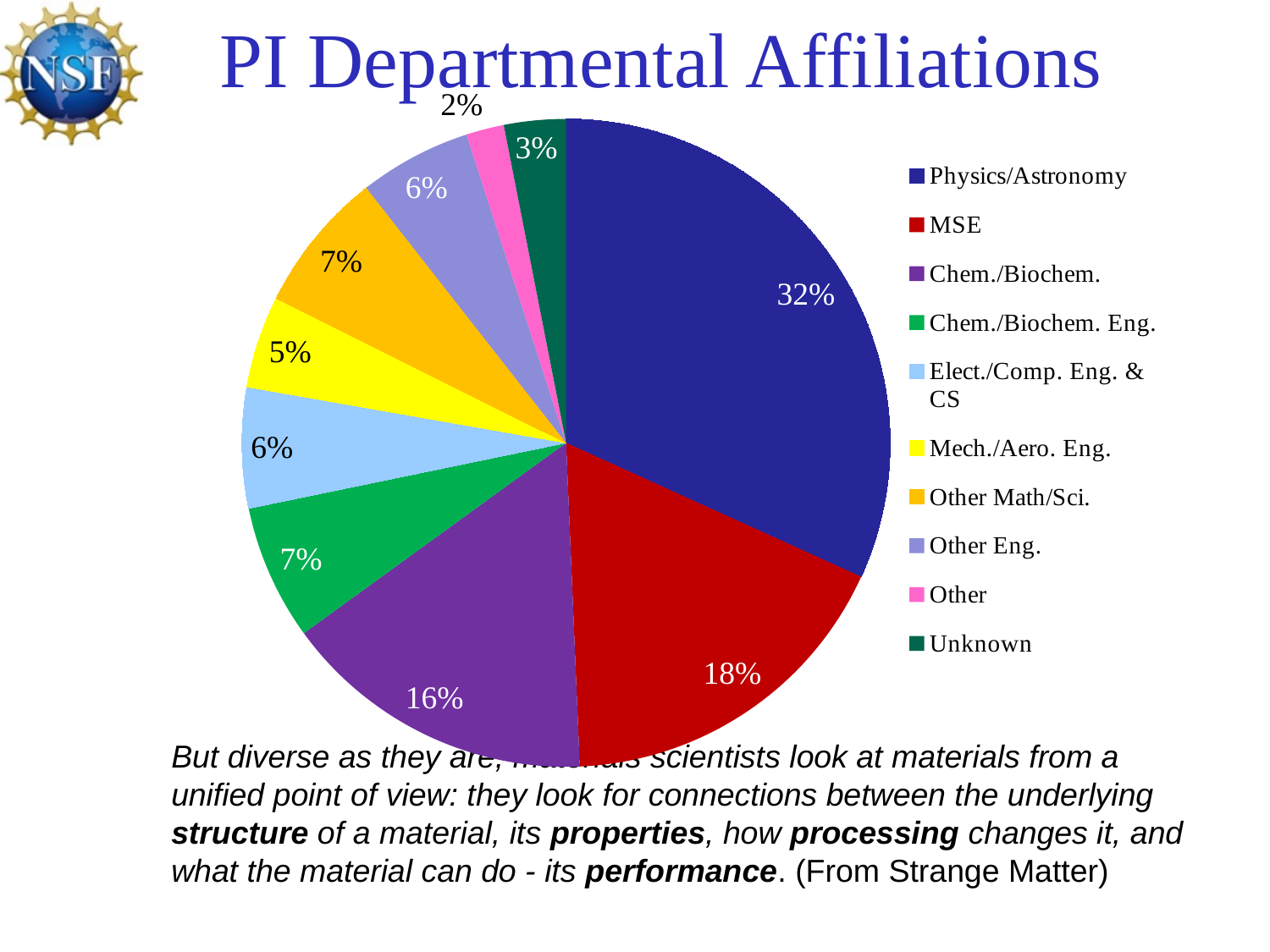
What share of the pie is MSE? 18% What share of the pie is Chem./Biochem.? 16% What is the title of the chart? PI Departmental Affiliations What share of the pie is Unknown? 3% Which is larger, the share for Chem./Biochem. or the share for Other Math/Sci.? Chem./Biochem. How many categories does the legend list? 10 What type of chart is shown on the slide? pie chart What is the difference in percentage points between Physics/Astronomy and MSE? 14 Which category has the largest share of the pie? Physics/Astronomy Which category has the smallest share of the pie? Other